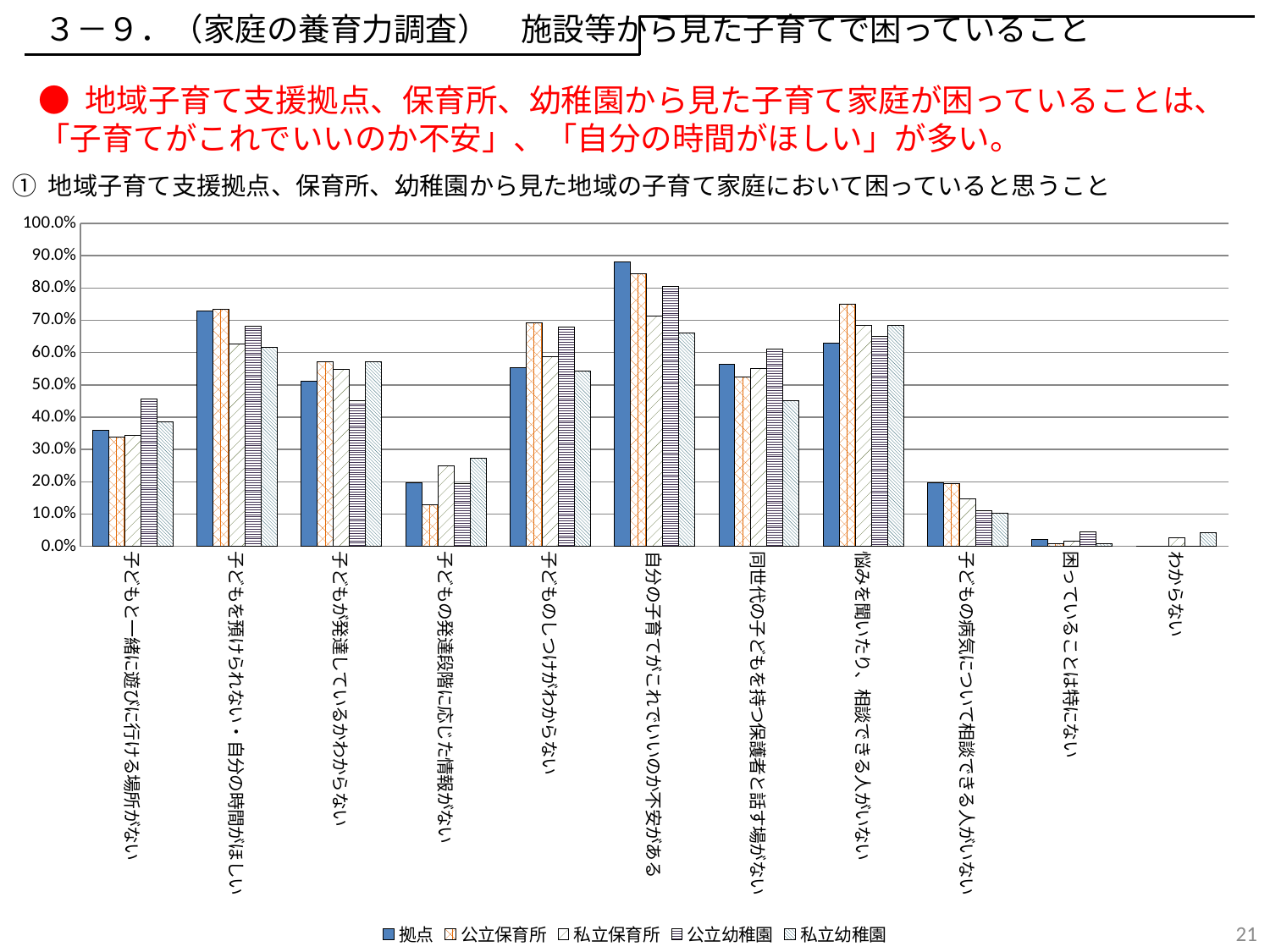
In the category 子どもと一緒に遊びに行ける場所がない, which is larger: 拠点 or 公立幼稚園? 公立幼稚園 Which series has the highest value in the category 悩みを聞いたり、相談できる人がいない? 公立保育所 In the category 自分の子育てがこれでいいのか不安がある, which is larger: 拠点 or 私立幼稚園? 拠点 How many series does the legend list? 5 Is the value for 拠点 in the category 子どもの発達段階に応じた情報がない greater or less than 30.0%? less Is the value for 公立保育所 in the category 悩みを聞いたり、相談できる人がいない greater or less than 70.0%? greater How many categories are shown on the x axis? 11 What is the first series listed in the legend? 拠点 What kind of chart is shown on the slide? bar chart Is the value for 拠点 in the category 自分の子育てがこれでいいのか不安がある greater or less than 80.0%? greater Which category has the highest value for the 拠点 series? 自分の子育てがこれでいいのか不安がある